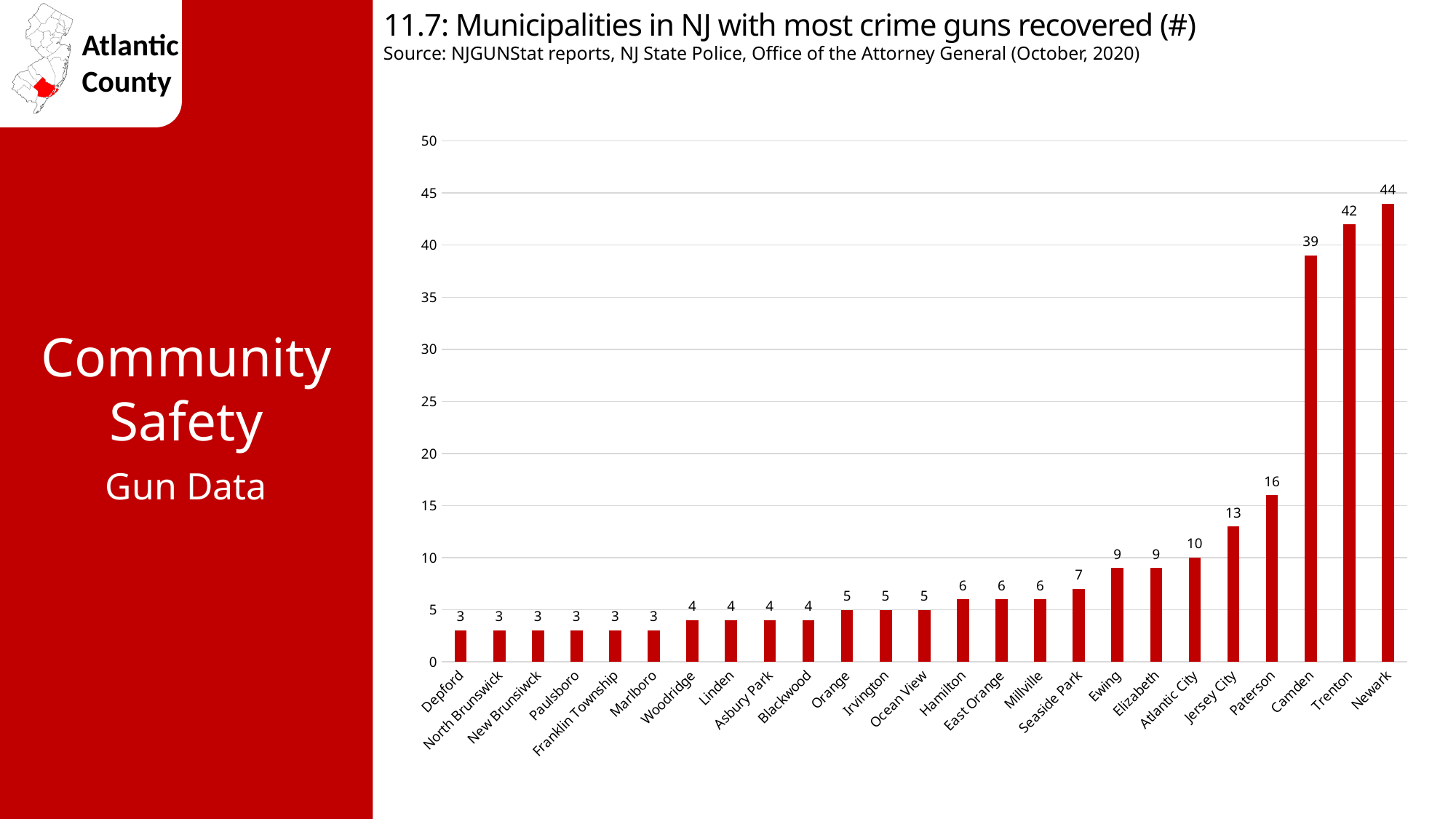
Which municipality has the highest number of crime guns recovered? Newark What is the title of the chart? 11.7: Municipalities in NJ with most crime guns recovered (#) Do the values generally rise or fall moving from left to right along the x axis? Rise Which has a larger value, Camden or Paterson? Camden What is the difference between the values for Newark and Trenton? 2 How many municipalities are shown on the chart? 25 What is the value shown for Camden? 39 How many crime guns were recovered in Newark? 44 What kind of chart is shown on the slide? Bar chart Is the value for Trenton greater or less than 40? greater What is the value shown for Atlantic City? 10 What is the difference between the values for Paterson and Jersey City? 3